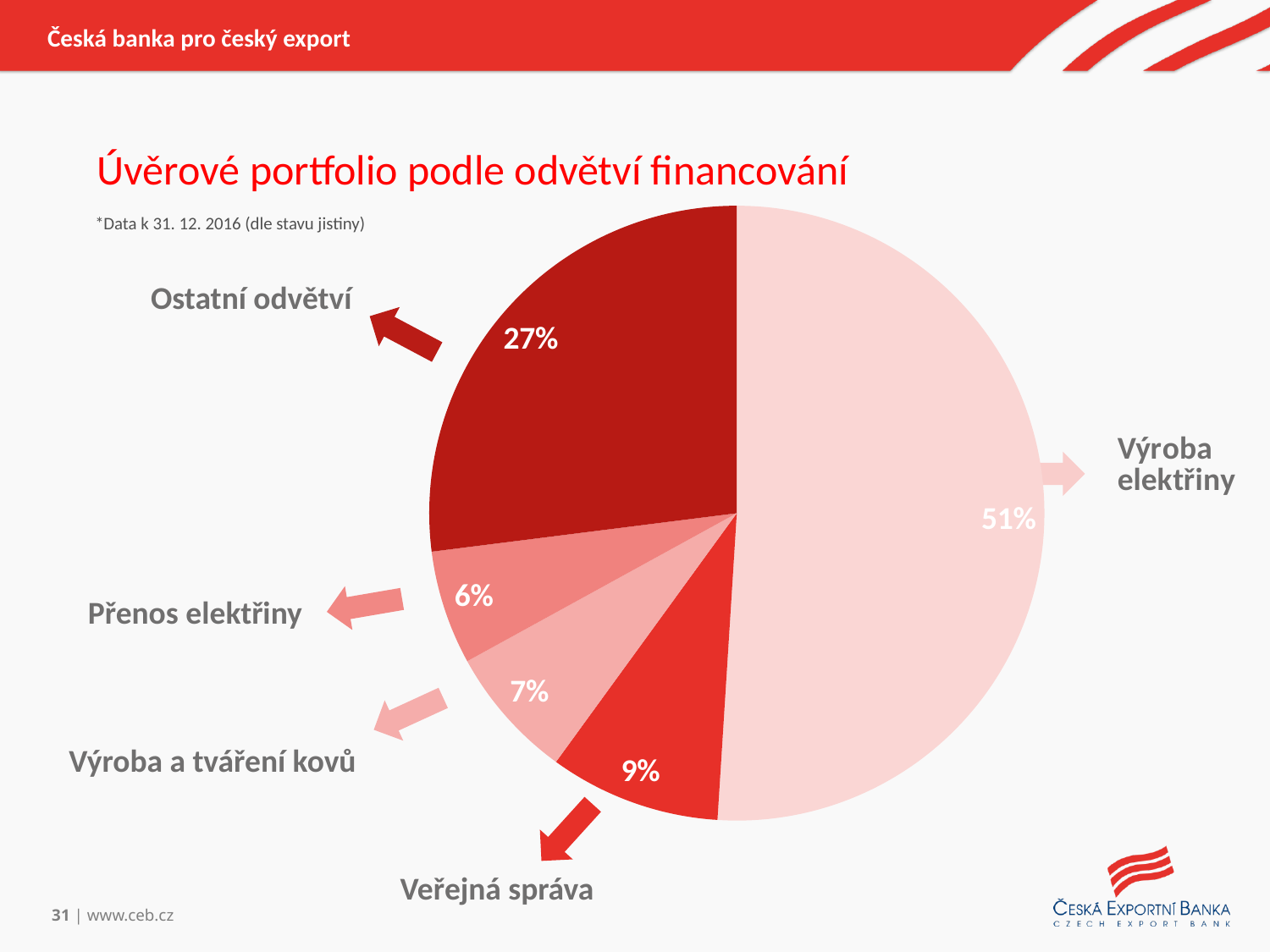
Which is larger, the share for Veřejná správa or the share for Výroba a tváření kovů? Veřejná správa What percentage is labelled for Veřejná správa? 9% What is the difference between the shares of Výroba elektřiny and Ostatní odvětví? 24 percentage points What share of the pie does Výroba elektřiny hold? 51% What is the value for Přenos elektřiny? 6% What is the title of the chart on the slide? Úvěrové portfolio podle odvětví financování What is the value shown for Ostatní odvětví? 27% What type of chart is shown on the slide? Pie chart What is the value for Výroba a tváření kovů? 7% Which category has the smallest slice of the pie? Přenos elektřiny How many categories are shown in the pie chart? 5 Which category has the largest slice of the pie? Výroba elektřiny